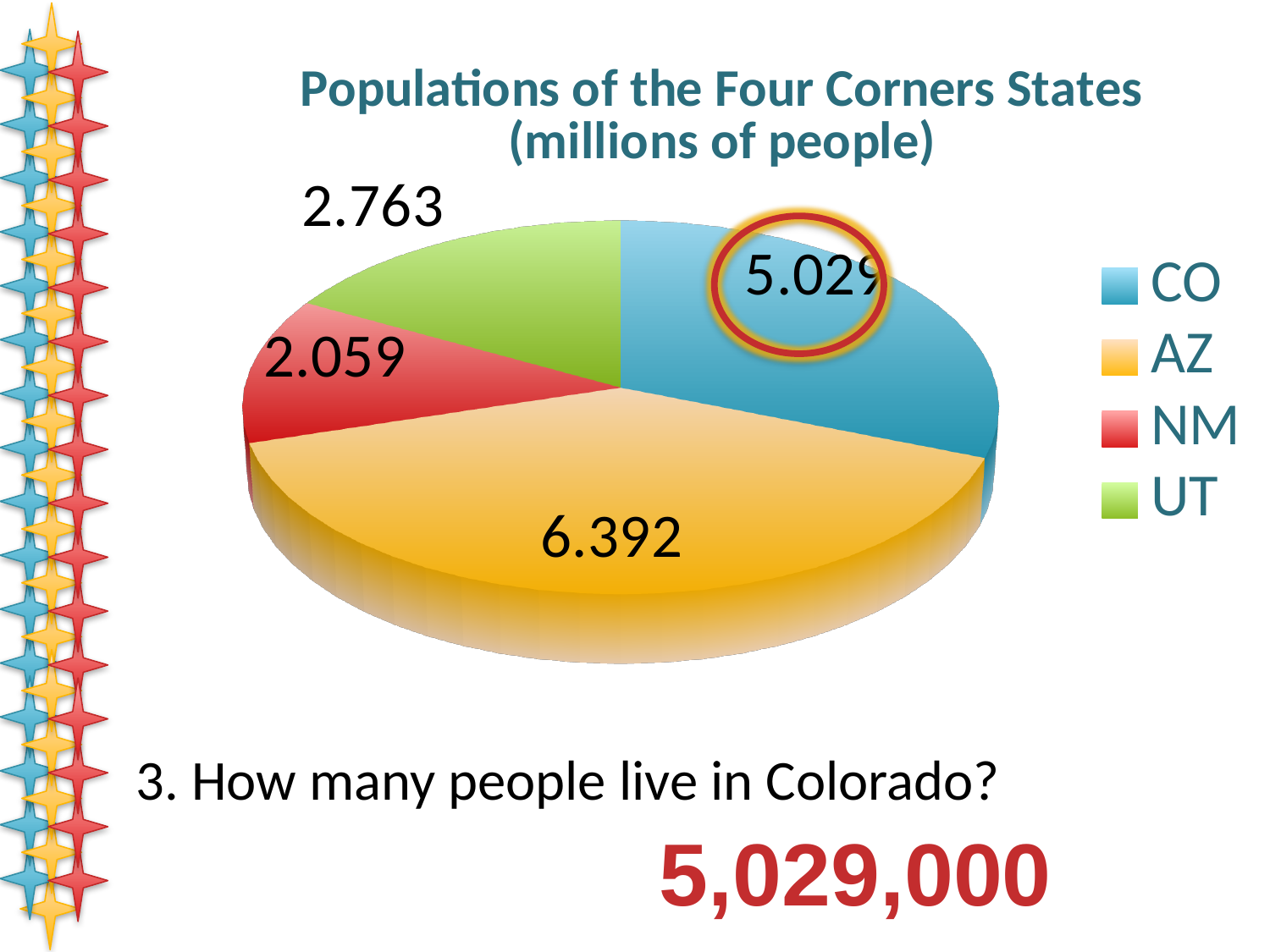
Which state has the largest slice of the pie chart? AZ What is the title of the chart? Populations of the Four Corners States (millions of people) Which is larger, the value for CO or the value for UT? CO How many slices does the pie chart have? 4 What is the value shown for AZ in the pie chart? 6.392 Which state has the smallest slice of the pie chart? NM What kind of chart is shown on the slide? Pie chart What is the difference between the values for AZ and CO? 1.363 What is the difference between the values for UT and NM? 0.704 What is the value shown for UT in the pie chart? 2.763 What is the value shown for NM in the pie chart? 2.059 What is the value shown for CO in the pie chart? 5.029